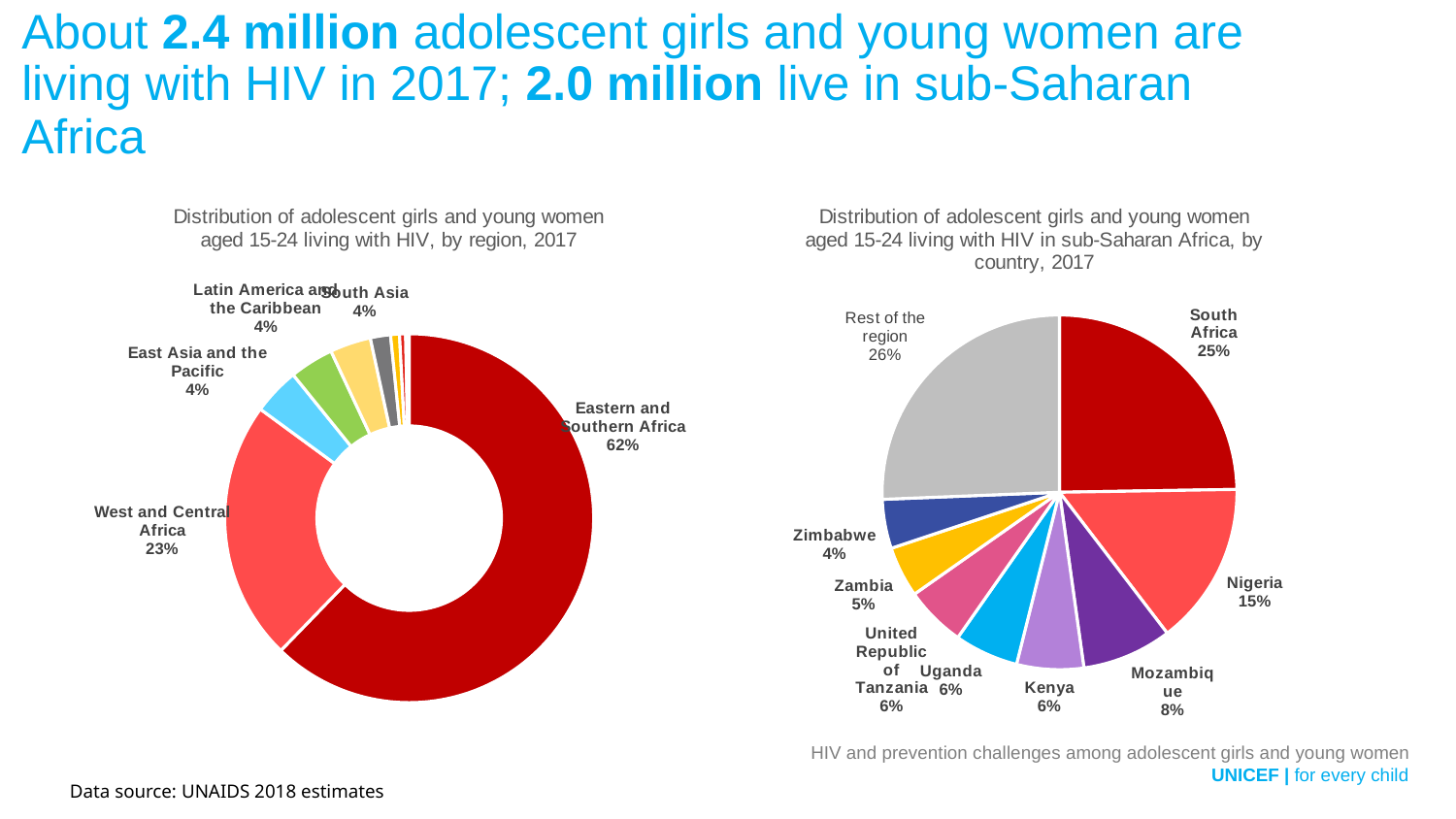
In the chart on the right (by country), what share is shown for Nigeria? 15% In the chart on the left (by region), what share is shown for West and Central Africa? 23% What kind of chart is the chart on the left (by region)? Donut chart In the chart on the right (by country), what share is shown for South Africa? 25% In the chart on the left (by region), what share of adolescent girls and young women living with HIV is in Eastern and Southern Africa? 62% What is the title of the chart on the right? Distribution of adolescent girls and young women aged 15-24 living with HIV in sub-Saharan Africa, by country, 2017 In the chart on the right (by country), what is the difference in percentage points between South Africa and Nigeria? 10 percentage points In the chart on the left (by region), which region has the largest share? Eastern and Southern Africa In the chart on the right (by country), which is larger: the share for Mozambique or the share for Zambia? Mozambique How many slices does the chart on the right (by country) have? 9 In the chart on the left (by region), what is the difference in percentage points between Eastern and Southern Africa and West and Central Africa? 39 percentage points In the chart on the right (by country), which named country has the smallest share? Zimbabwe